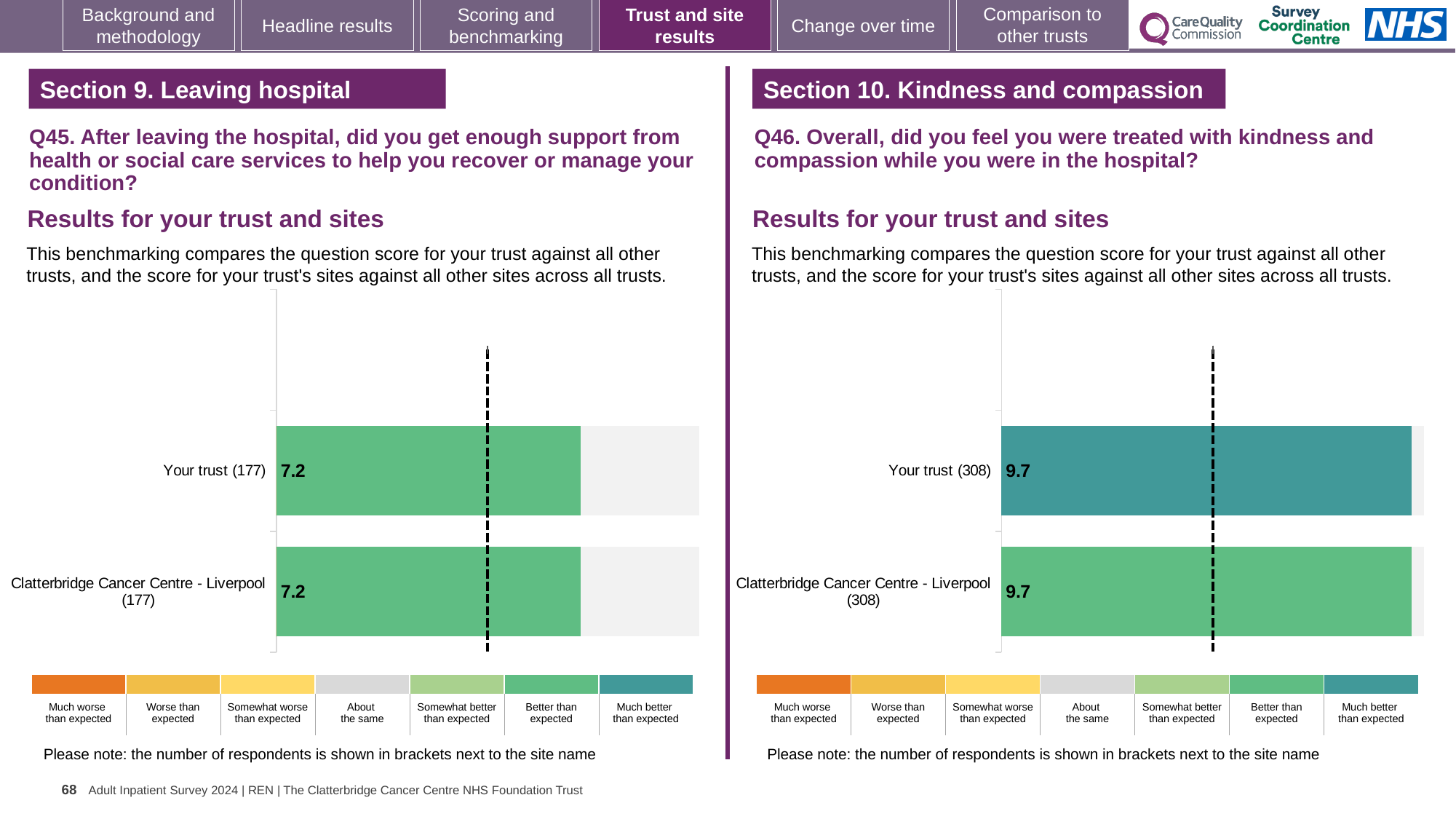
How many bars are plotted in the Q45 chart on the left? 2 In the Q45 chart on the left, what is the score for Your trust (177)? 7.2 In the Q46 chart on the right, what is the score for Your trust (308)? 9.7 In the Q45 chart on the left, what is the score for Clatterbridge Cancer Centre - Liverpool (177)? 7.2 How many respondents are shown in brackets for Your trust in the Q46 chart on the right? 308 In the Q45 chart on the left, what is the difference between the score for Your trust and the score for Clatterbridge Cancer Centre - Liverpool? 0.0 In the Q46 chart on the right, what is the difference between the score for Your trust and the score for Clatterbridge Cancer Centre - Liverpool? 0.0 In the Q46 chart on the right, which benchmark category does the colour of the Your trust (308) bar correspond to? Much better than expected In the Q45 chart on the left, which benchmark category does the colour of the Your trust (177) bar correspond to? Better than expected What kind of chart is used for the Q45 results on the left? Bar chart In the Q46 chart on the right, what is the score for Clatterbridge Cancer Centre - Liverpool (308)? 9.7 How many bars are plotted in the Q46 chart on the right? 2